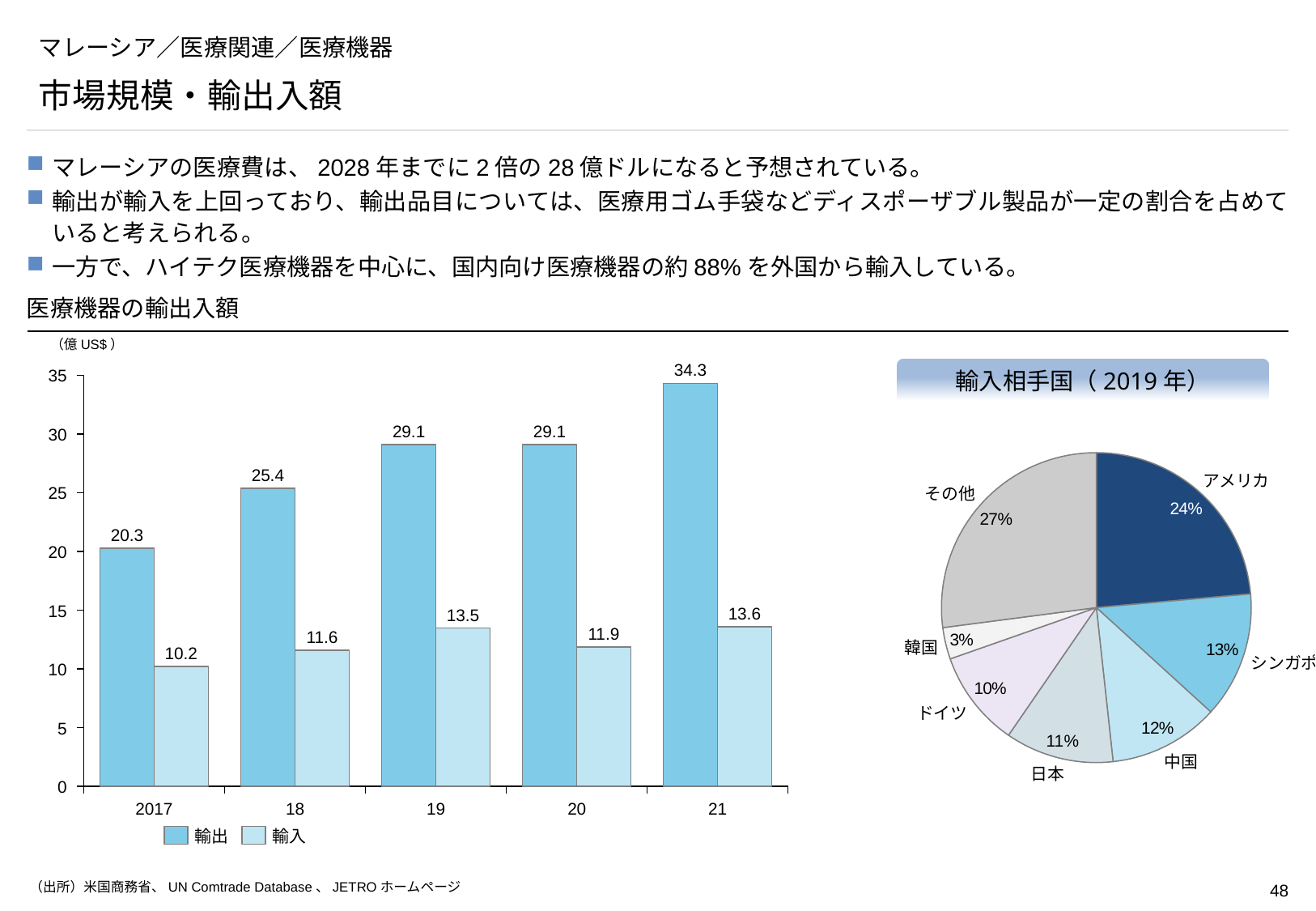
In the pie chart 輸入相手国（2019年）, which country has the smallest share? 韓国 In the bar chart 医療機器の輸出入額, which year has the lowest 輸入 value? 2017 In the bar chart 医療機器の輸出入額, how many series does the legend list? 2 What kind of chart is 輸入相手国（2019年）? pie chart In the bar chart 医療機器の輸出入額, is the 輸入 value for 2020 greater or less than 15? less In the bar chart 医療機器の輸出入額, what is the difference between 輸出 and 輸入 in 2019? 15.6 In the bar chart 医療機器の輸出入額, what is the value of 輸出 for 2021? 34.3 In the bar chart 医療機器の輸出入額, what is the value of 輸入 for 2017? 10.2 In the pie chart 輸入相手国（2019年）, what share does アメリカ have? 24% In the pie chart 輸入相手国（2019年）, which is larger, the share of 日本 or the share of 中国? 中国 In the bar chart 医療機器の輸出入額, does the 輸出 value rise or fall from 2017 to 2021? rise In the bar chart 医療機器の輸出入額, which year has the highest 輸出 value? 2021